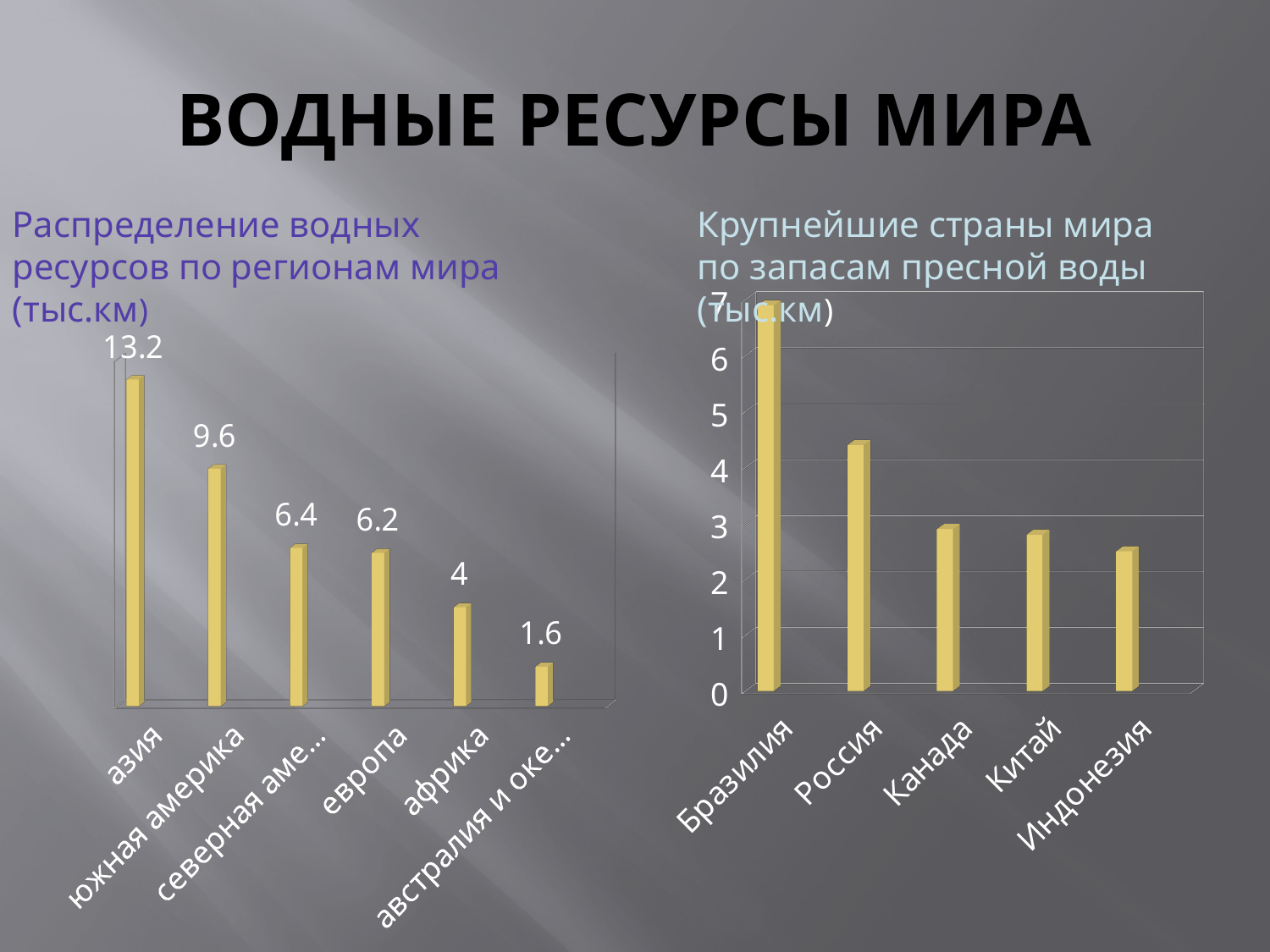
In the right chart (Крупнейшие страны мира по запасам пресной воды), which country has the highest value? Бразилия In the left chart (Распределение водных ресурсов по регионам мира), what is the difference between the values for азия and южная америка? 3.6 What kind of chart is the right chart (Крупнейшие страны мира по запасам пресной воды)? bar chart In the left chart (Распределение водных ресурсов по регионам мира), what is the value for азия? 13.2 In the right chart (Крупнейшие страны мира по запасам пресной воды), is the value for Индонезия greater or less than 3? less In the left chart (Распределение водных ресурсов по регионам мира), do the values rise or fall from left to right? fall In the left chart (Распределение водных ресурсов по регионам мира), how many regions are shown? 6 In the left chart (Распределение водных ресурсов по регионам мира), which region has the lowest value? австралия и оке... In the left chart (Распределение водных ресурсов по регионам мира), what is the value for европа? 6.2 In the right chart (Крупнейшие страны мира по запасам пресной воды), is the value for Россия greater or less than 4? greater In the left chart (Распределение водных ресурсов по регионам мира), which region has the highest value? азия In the left chart (Распределение водных ресурсов по регионам мира), what is the value for африка? 4